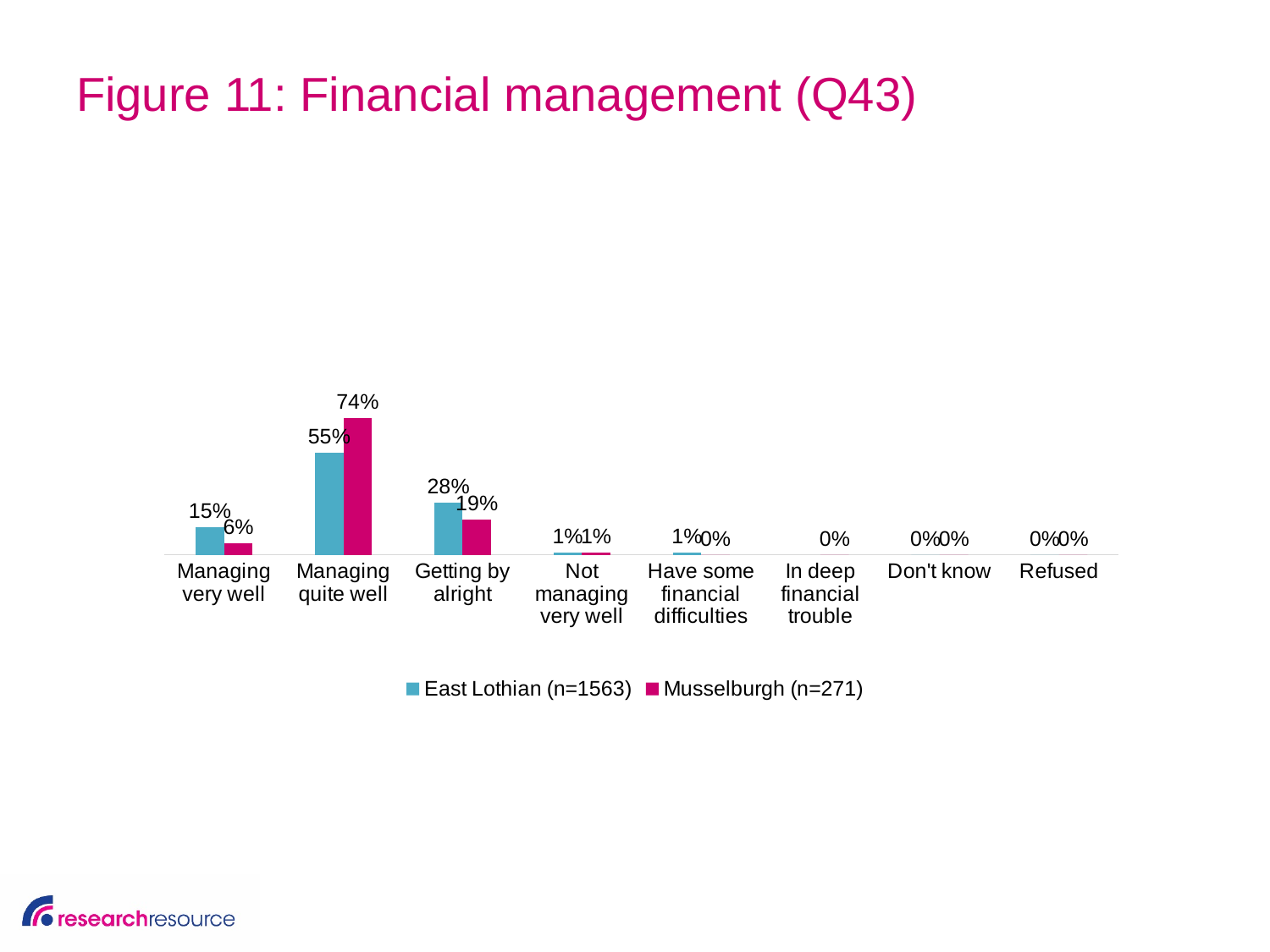
What is the value for Musselburgh in the 'Getting by alright' category? 19% Which category has the highest value for Musselburgh? Managing quite well Which category has the highest value for East Lothian? Managing quite well What is the value for East Lothian in the 'Managing very well' category? 15% What is the value for Musselburgh in the 'Managing very well' category? 6% How many categories are shown on the x axis? 8 What is the value for East Lothian in the 'Managing quite well' category? 55% Which is larger for 'Managing very well': East Lothian or Musselburgh? East Lothian What is the difference between the East Lothian and Musselburgh values for 'Getting by alright'? 9% How many series does the legend list? 2 What kind of chart is shown on the slide? Bar chart What is the difference between the Musselburgh and East Lothian values for 'Managing quite well'? 19%